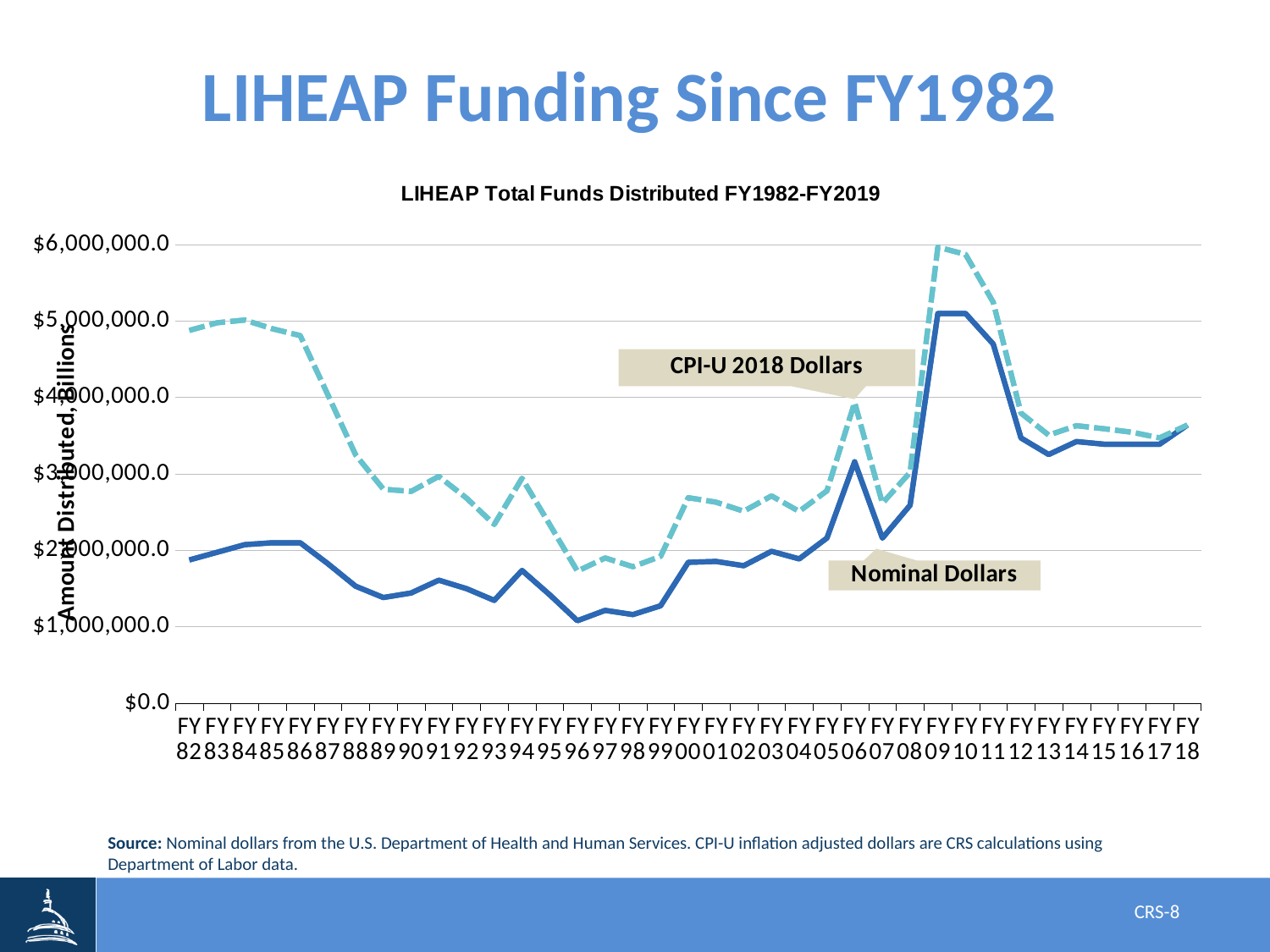
What kind of chart is shown on the slide? line chart What is the title of the chart? LIHEAP Total Funds Distributed FY1982-FY2019 Is the CPI-U 2018 Dollars value for FY89 greater or less than $3,000,000.0? less Does the Nominal Dollars series rise or fall from FY86 to FY96? fall How many series are plotted on the chart? 2 What is the label of the y axis? Amount Distributed, Billions For FY82, which series has the larger value, CPI-U 2018 Dollars or Nominal Dollars? CPI-U 2018 Dollars How many fiscal years are plotted along the x axis? 37 In which fiscal year is the Nominal Dollars series at its lowest? FY96 Is the Nominal Dollars value for FY82 greater or less than $2,000,000.0? less Is the Nominal Dollars value for FY06 greater or less than $3,000,000.0? greater